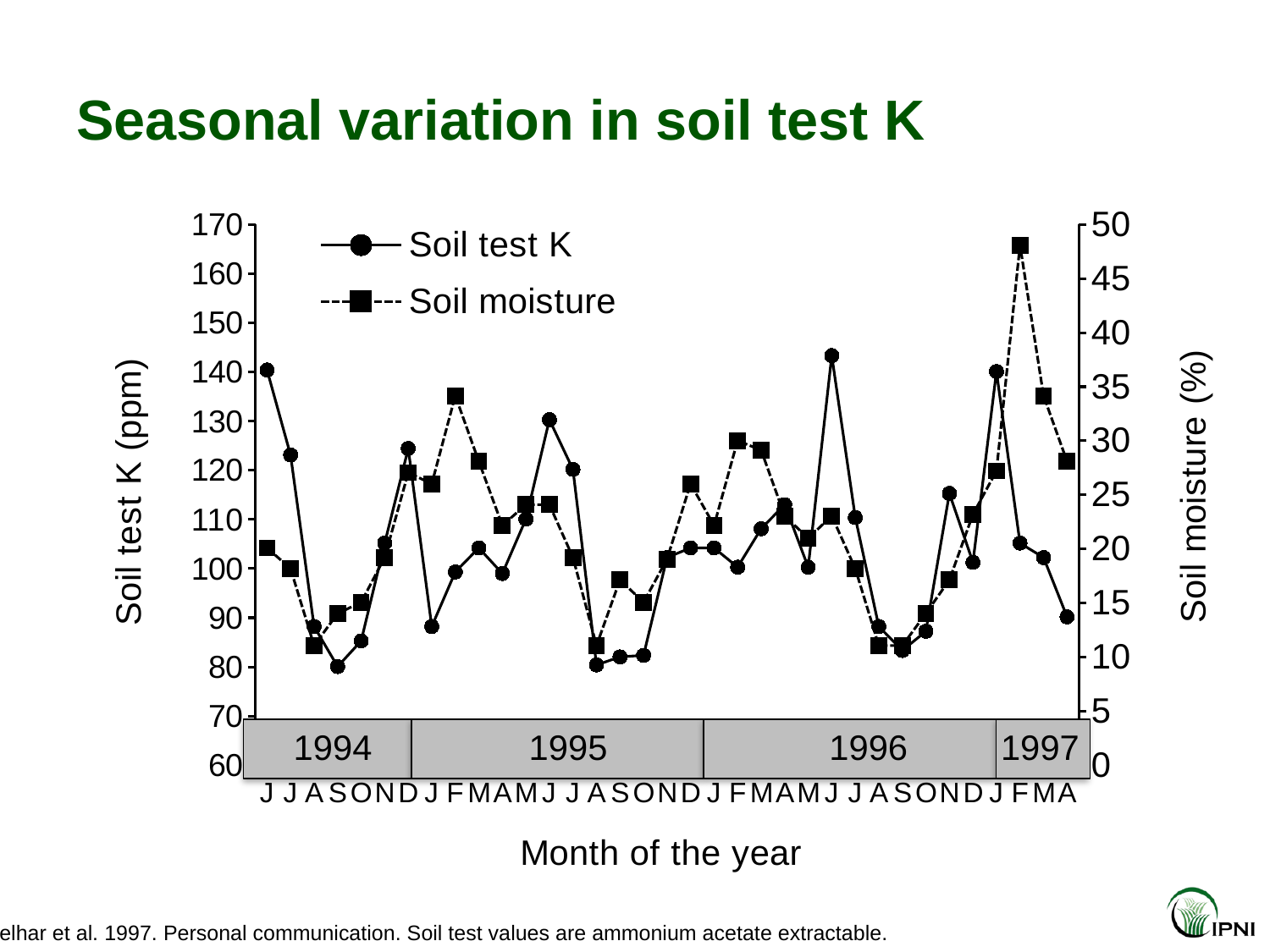
Is the soil test K value in June 1996 greater or less than 130? greater In which month and year does soil moisture reach its highest value? February 1997 What kind of chart is shown on the slide? Line chart Is the soil moisture value in February 1997 greater or less than 40? greater How many years are labelled along the x axis? 4 Which is larger, the soil moisture in February 1997 or the soil moisture in February 1995? February 1997 Is the soil test K value in September 1994 greater or less than 90? less Does soil test K rise or fall from June 1994 to September 1994? Fall What are the two series named in the legend? Soil test K and Soil moisture How many series does the legend list? 2 What is the title of the chart? Seasonal variation in soil test K